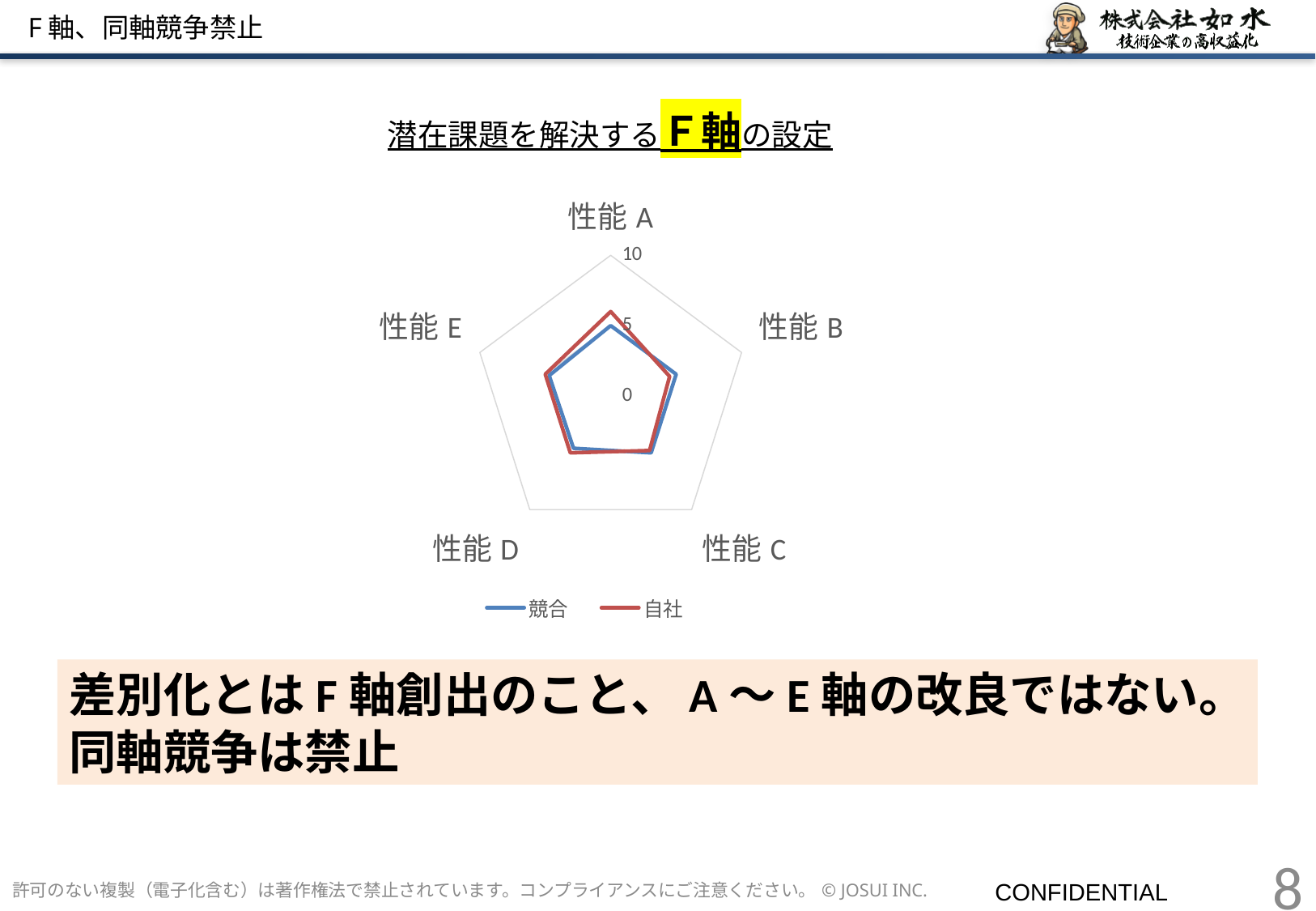
What colour is the line for the 自社 series? red How many categories (axes) does the radar chart have? 5 Is the value for 性能C in the 自社 series greater or less than 10? less Is the value for 性能A in the 競合 series greater or less than 10? less How many series does the legend list? 2 What are the two series named in the legend? 競合 and 自社 What is the maximum value shown on the radar chart's axis scale? 10 Is the value for 性能E in the 競合 series greater or less than 10? less What kind of chart is shown on the slide? radar chart